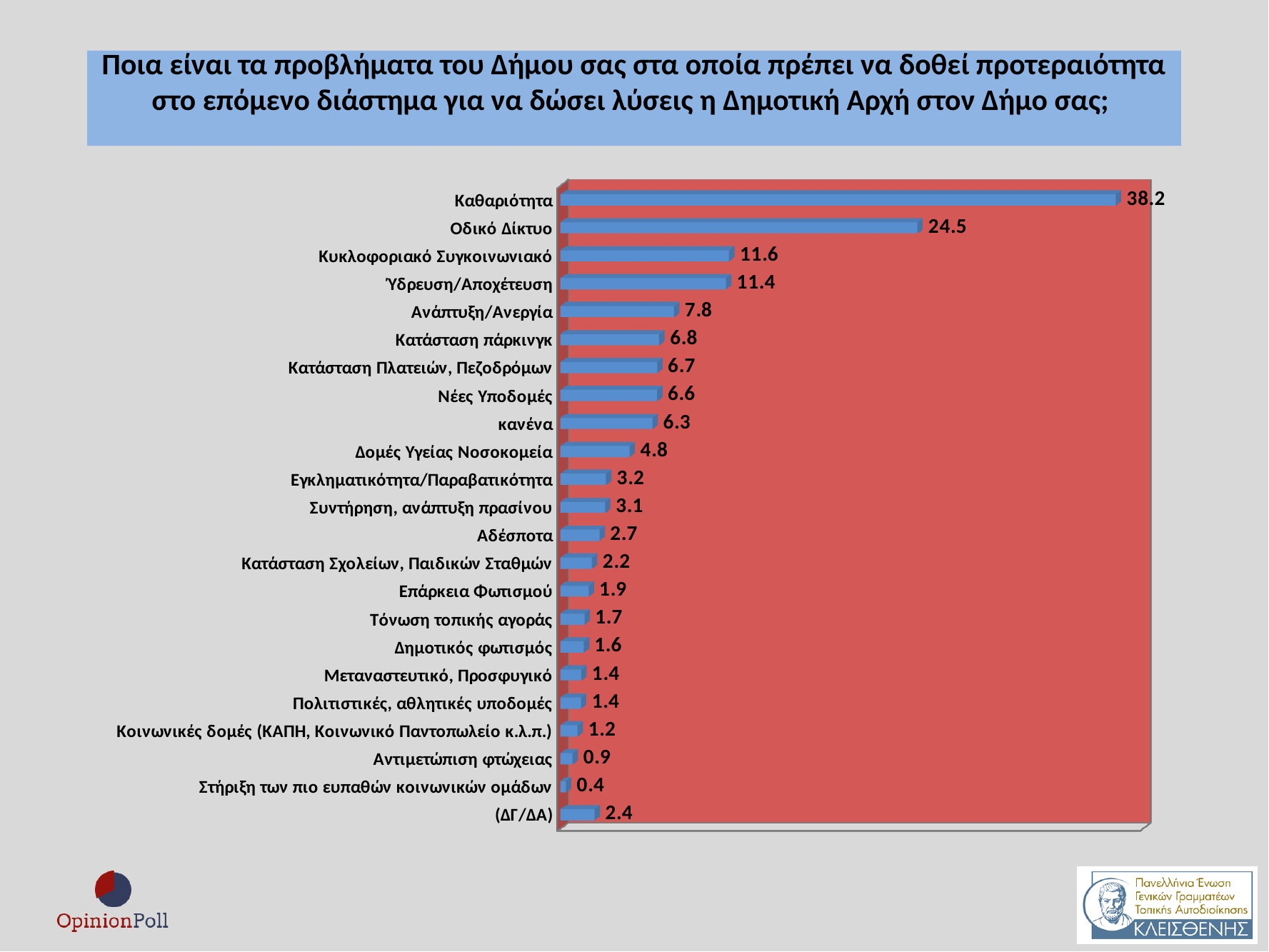
What is the difference between the values for Καθαριότητα and Οδικό Δίκτυο? 13.7 What value is shown for Ύδρευση/Αποχέτευση? 11.4 Which category has the lowest value? Στήριξη των πιο ευπαθών κοινωνικών ομάδων What value is shown for Καθαριότητα? 38.2 What colour are the bars in the chart? Blue Which is larger, the value for Δομές Υγείας Νοσοκομεία or the value for Αδέσποτα? Δομές Υγείας Νοσοκομεία Which category has the highest value? Καθαριότητα What value is shown for (ΔΓ/ΔΑ)? 2.4 What kind of chart is shown on the slide? Bar chart What is the difference between the values for Κυκλοφοριακό Συγκοινωνιακό and Ανάπτυξη/Ανεργία? 3.8 How many categories are shown in the chart? 23 What value is shown for Οδικό Δίκτυο? 24.5